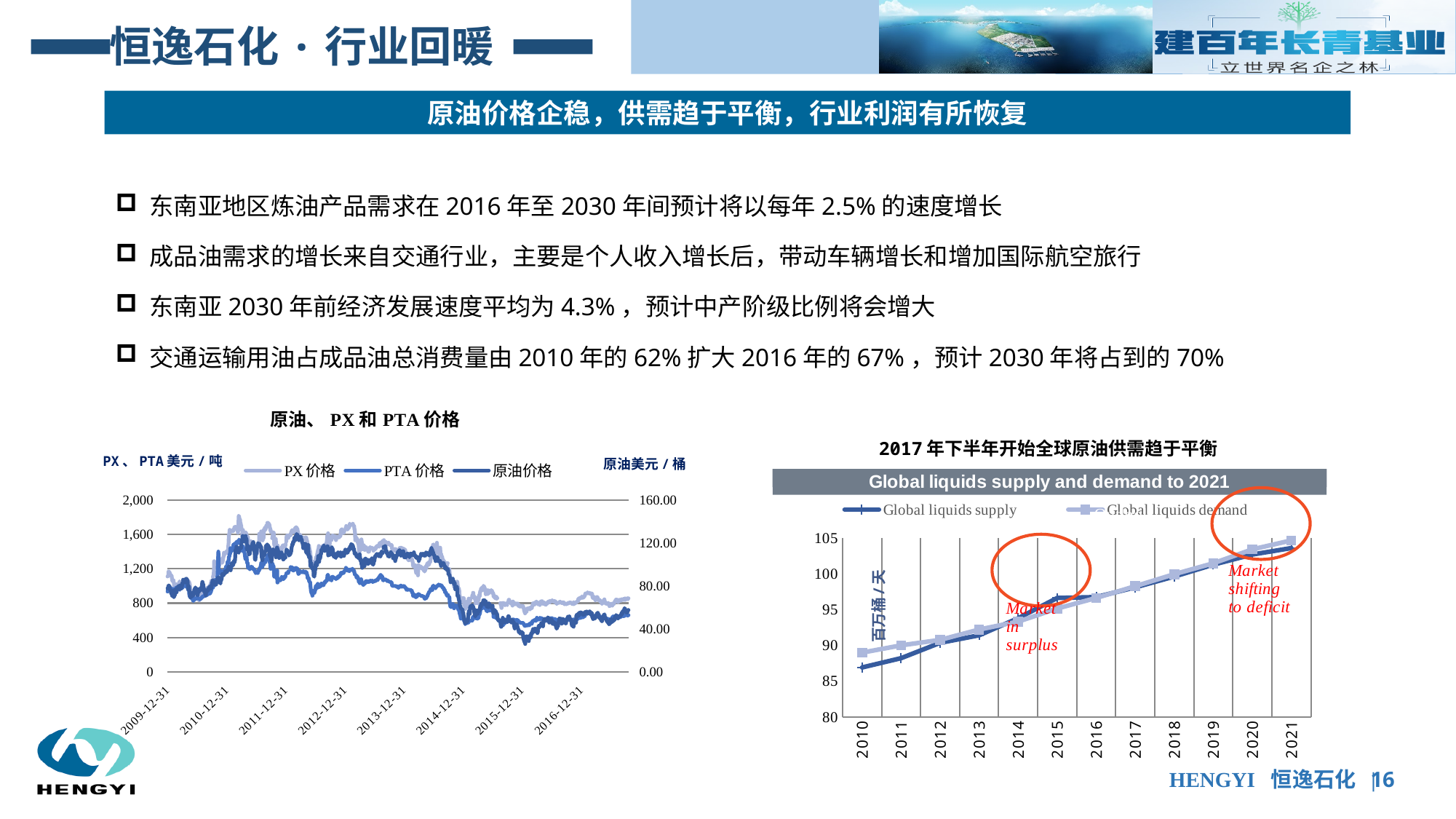
What kind of chart is the right chart titled Global liquids supply and demand to 2021? line chart How many series does the legend of the left chart (原油、PX和PTA价格) list? 3 In the right chart (Global liquids supply and demand to 2021), do the Global liquids demand values rise or fall from 2010 to 2021? rise In the left chart (原油、PX和PTA价格), is the 原油价格 value at 2016-12-31 greater or less than 80.00? less How many series does the legend of the right chart (Global liquids supply and demand to 2021) list? 2 In the left chart (原油、PX和PTA价格), does the 原油价格 series rise or fall between 2014-12-31 and 2015-12-31? fall What kind of chart is the left chart titled 原油、PX和PTA价格? line chart How many years are shown on the x axis of the right chart (Global liquids supply and demand to 2021)? 12 In the right chart (Global liquids supply and demand to 2021), is the Global liquids demand value for 2021 greater or less than 100? greater In the right chart (Global liquids supply and demand to 2021), is the Global liquids supply value for 2010 greater or less than 90? less In the left chart (原油、PX和PTA价格), which series is plotted on the right-hand axis labelled 原油美元/桶? 原油价格